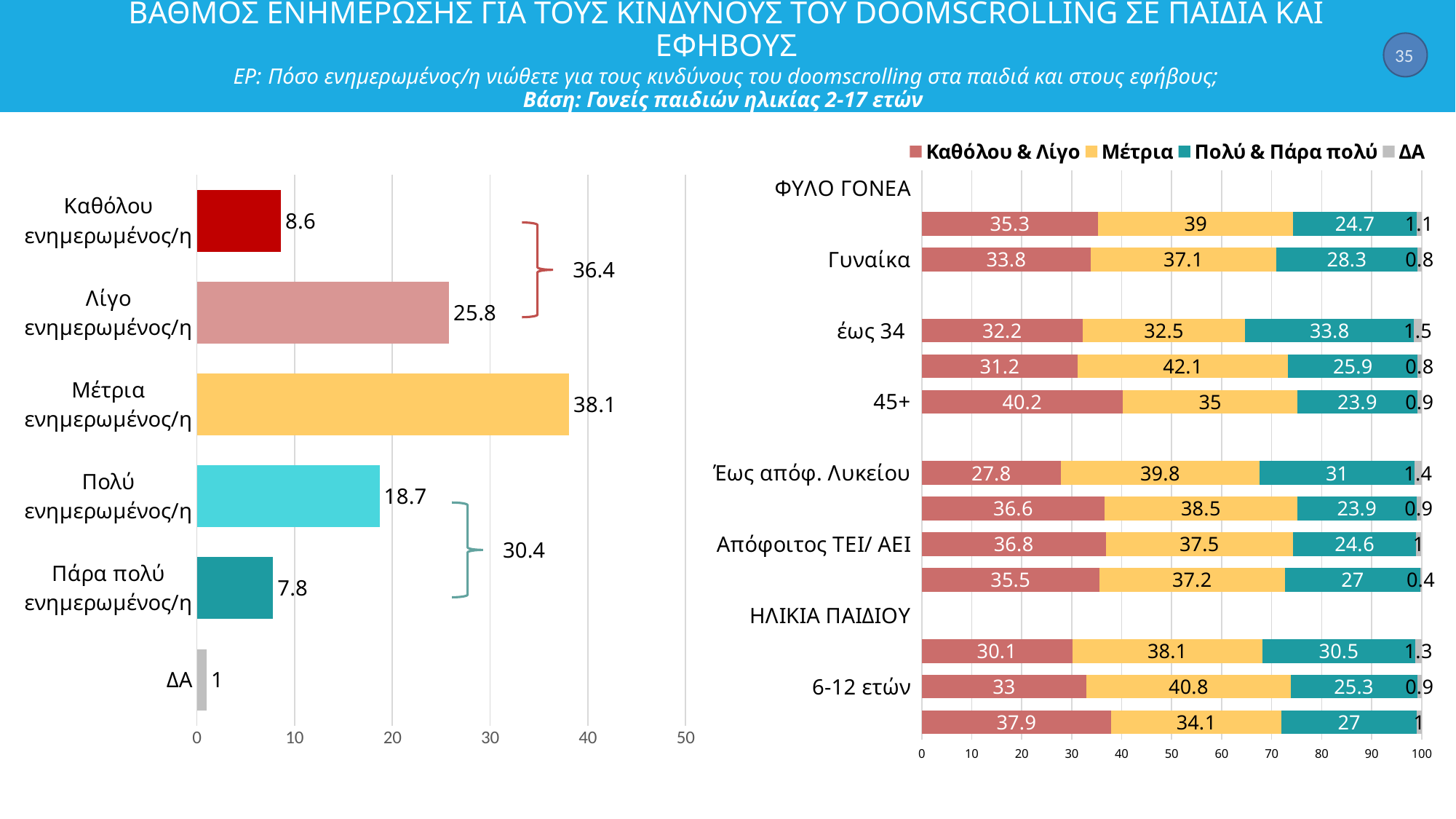
In the left bar chart, what is the value for Πάρα πολύ ενημερωμένος/η? 7.8 In the left bar chart, which category has the lowest value? ΔΑ In the right stacked bar chart, what is the Μέτρια value for Γυναίκα? 37.1 In the left bar chart, what is the value for Μέτρια ενημερωμένος/η? 38.1 How many categories does the left bar chart show? 6 In the left bar chart, what is the difference between Λίγο ενημερωμένος/η and Καθόλου ενημερωμένος/η? 17.2 In the left bar chart, which category has the highest value? Μέτρια ενημερωμένος/η In the right stacked bar chart, what is the Καθόλου & Λίγο value for 45+? 40.2 What type of chart is shown on the right side of the slide? Stacked bar chart In the right stacked bar chart, what is the Πολύ & Πάρα πολύ value for 6-12 ετών? 25.3 How many series does the legend of the right stacked bar chart list? 4 In the left bar chart, which is larger: Πολύ ενημερωμένος/η or Λίγο ενημερωμένος/η? Λίγο ενημερωμένος/η